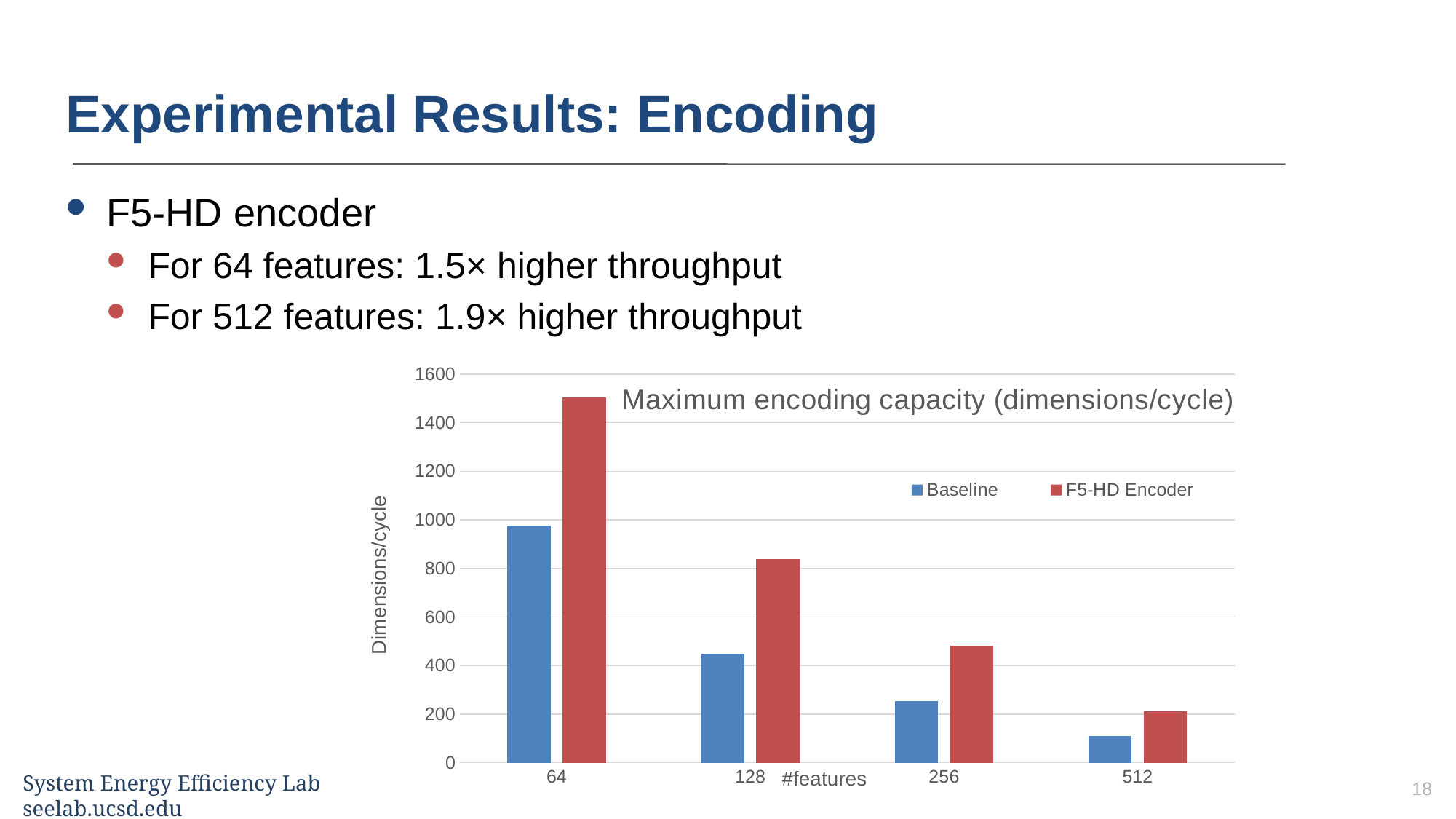
How many series does the chart legend list? 2 Which #features category has the highest F5-HD Encoder value? 64 Is the Baseline value for 64 features greater or less than 800? greater Which #features category has the lowest Baseline value? 512 For 128 features, which series has the larger value, Baseline or F5-HD Encoder? F5-HD Encoder Do the Baseline values rise or fall as #features increases along the x axis? fall Is the Baseline value for 256 features greater or less than 400? less What is the title of the chart? Maximum encoding capacity (dimensions/cycle) Is the F5-HD Encoder value for 64 features greater or less than 1400? greater How many #features categories are shown on the x axis of the chart? 4 What kind of chart is shown on the slide? bar chart What is the label of the y axis of the chart? Dimensions/cycle